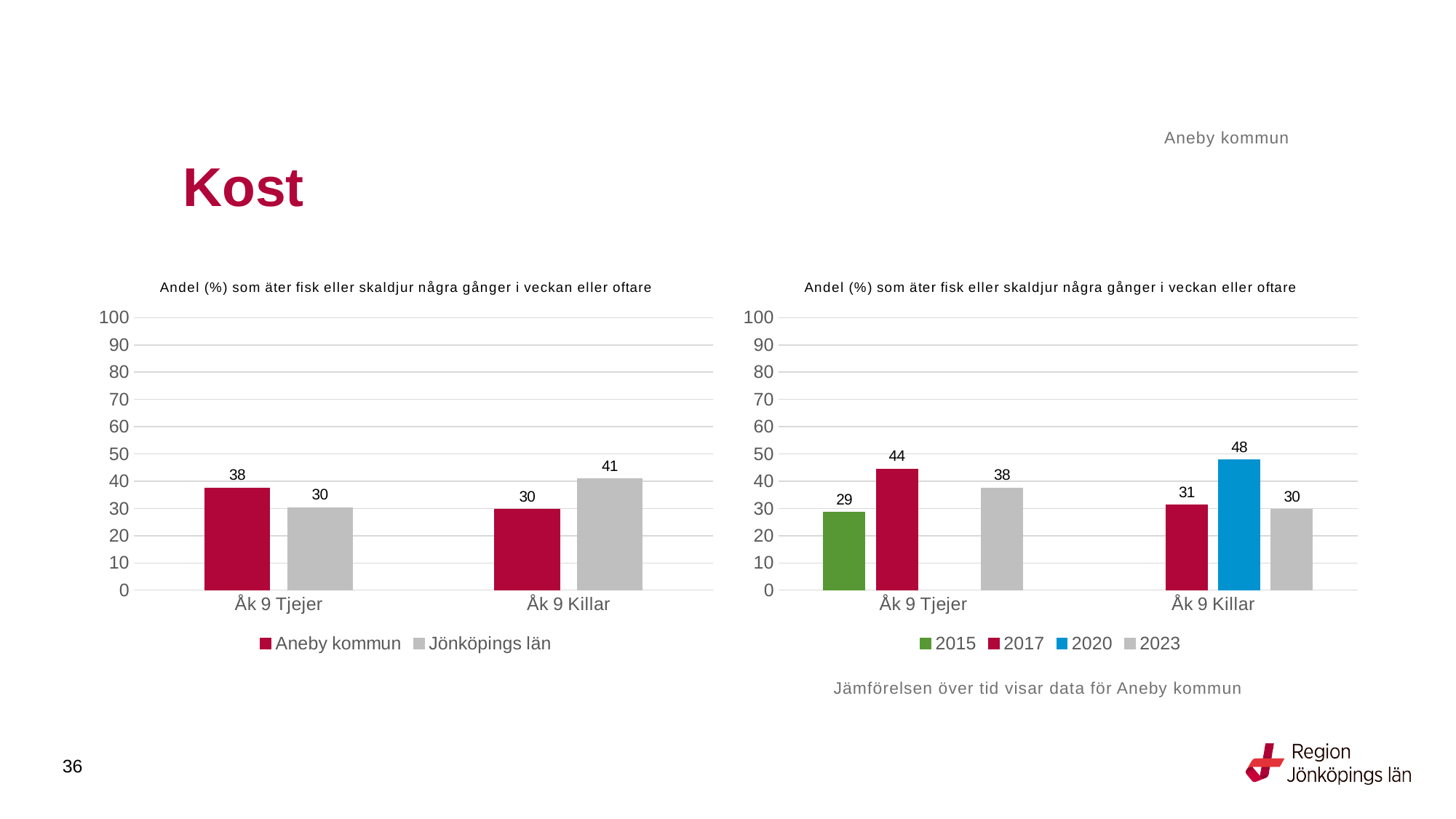
In the left chart, which is larger for Åk 9 Killar: Aneby kommun or Jönköpings län? Jönköpings län In the left chart, what is the value for Jönköpings län for Åk 9 Killar? 41 In the left chart, how many series does the legend list? 2 What kind of chart is the left chart? Bar chart In the right chart, what is the value for 2020 for Åk 9 Killar? 48 In the right chart, how many series does the legend list? 4 In the right chart, what is the difference between the 2020 and 2023 values for Åk 9 Killar? 18 In the right chart, which year has the lowest value for Åk 9 Tjejer? 2015 In the left chart, what is the value for Aneby kommun for Åk 9 Tjejer? 38 In the left chart, what is the difference between Aneby kommun and Jönköpings län for Åk 9 Tjejer? 8 In the right chart, which year has the highest value for Åk 9 Killar? 2020 In the right chart, what is the value for 2017 for Åk 9 Tjejer? 44